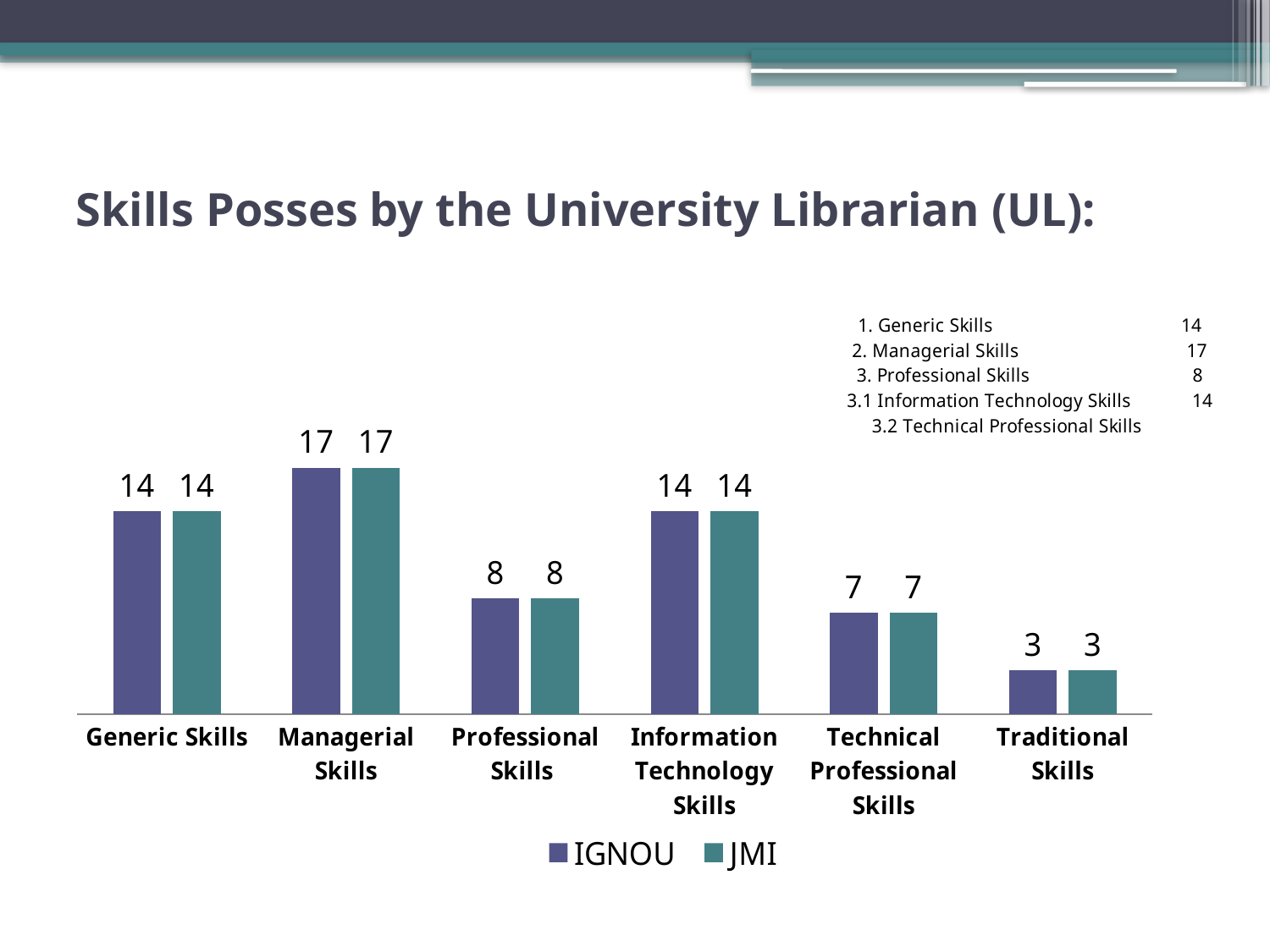
What is the IGNOU value for Technical Professional Skills? 7 What is the difference between the IGNOU values for Managerial Skills and Professional Skills? 9 Which category has the lowest value for IGNOU? Traditional Skills Which category has the highest value for JMI? Managerial Skills What is the IGNOU value for Managerial Skills? 17 What kind of chart is shown on the slide? Bar chart How many series does the legend list? 2 What are the two series named in the legend? IGNOU and JMI How many categories are shown on the x axis? 6 Which is larger for JMI: Generic Skills or Technical Professional Skills? Generic Skills What is the JMI value for Traditional Skills? 3 What is the difference between the JMI values for Information Technology Skills and Traditional Skills? 11